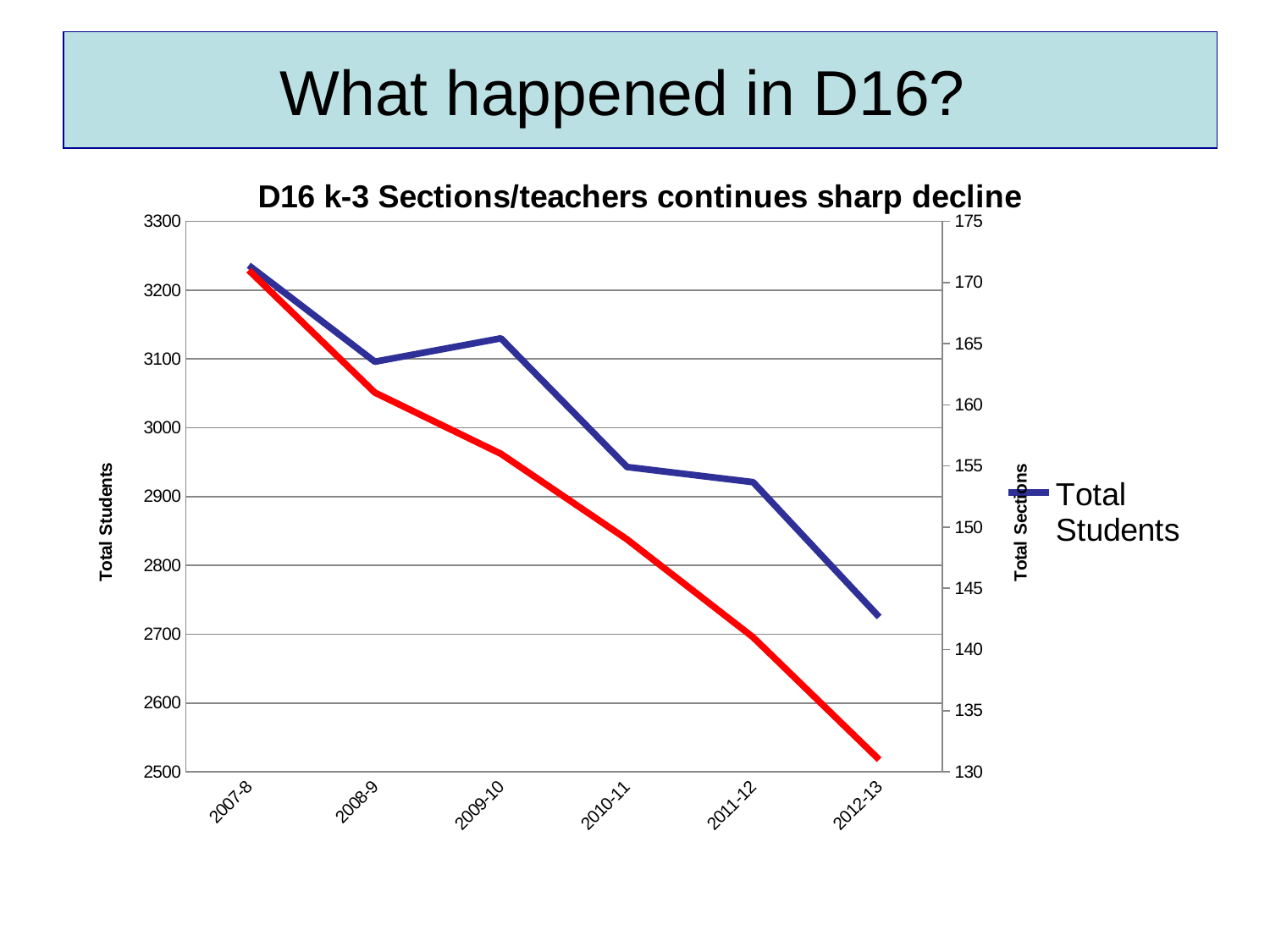
What is the label of the left vertical axis? Total Students In which school year is the red line at its highest? 2007-8 Do the values of the red line rise or fall from 2007-8 to 2012-13? fall In which school year is the blue line at its lowest? 2012-13 What kind of chart is shown on the slide? line chart On the blue line, which is higher: the value for 2008-9 or the value for 2009-10? 2009-10 How many entries does the chart legend list? 1 How many school years are plotted along the x axis? 6 What is the title of the chart? D16 k-3 Sections/teachers continues sharp decline